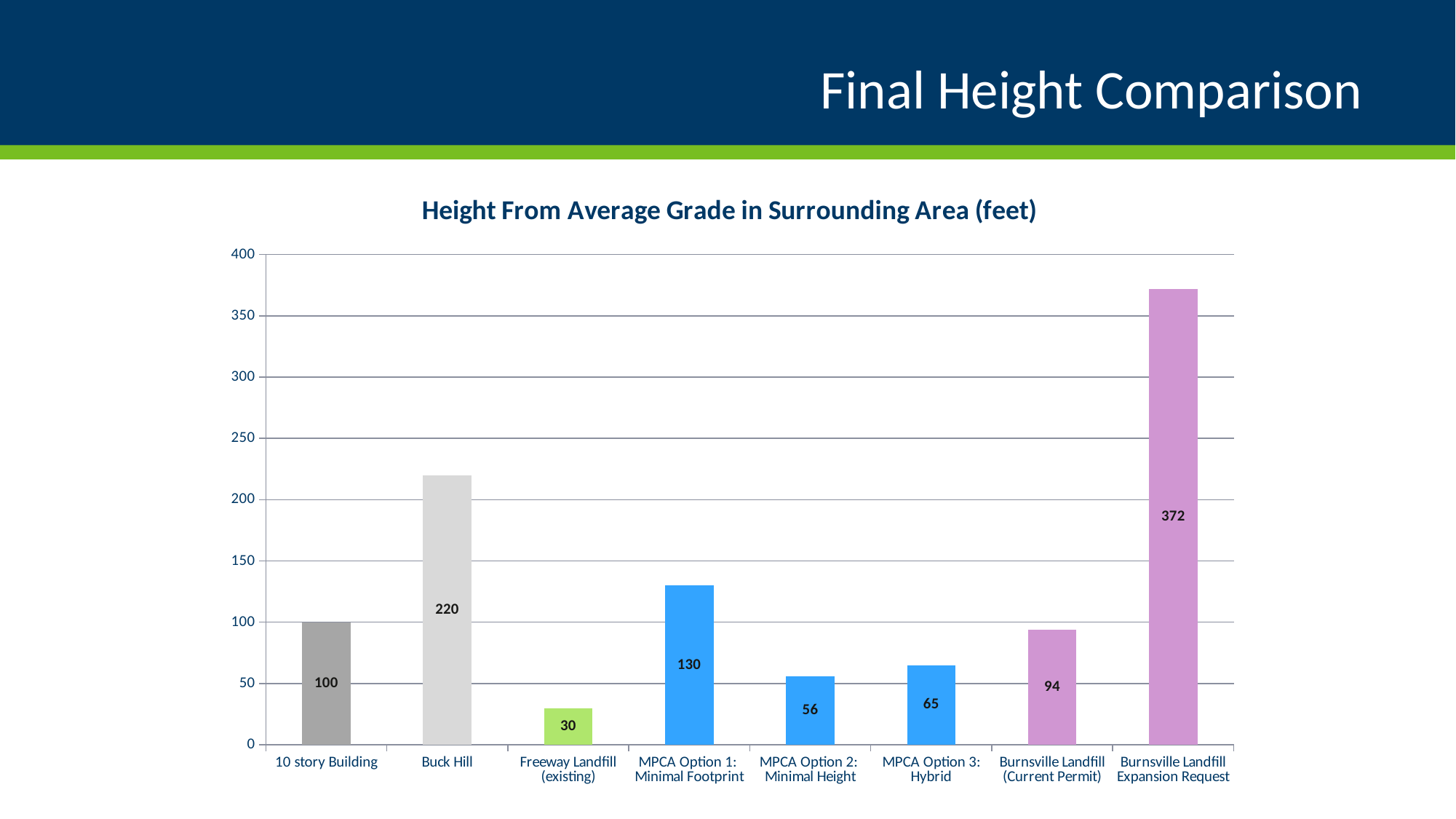
What is the height value shown for Buck Hill? 220 How many categories are shown on the x axis? 8 What is the title of the chart? Height From Average Grade in Surrounding Area (feet) Which is larger, the value for 10 story Building or the value for Burnsville Landfill (Current Permit)? 10 story Building Is the value for Buck Hill greater or less than 200? greater Which category has the lowest height value? Freeway Landfill (existing) What kind of chart is shown on the slide? bar chart What is the height value shown for MPCA Option 1: Minimal Footprint? 130 Which category has the highest height value? Burnsville Landfill Expansion Request What is the difference between the MPCA Option 3: Hybrid value and the MPCA Option 2: Minimal Height value? 9 What is the height value shown for Burnsville Landfill (Current Permit)? 94 What is the difference between the Burnsville Landfill Expansion Request value and the Buck Hill value? 152